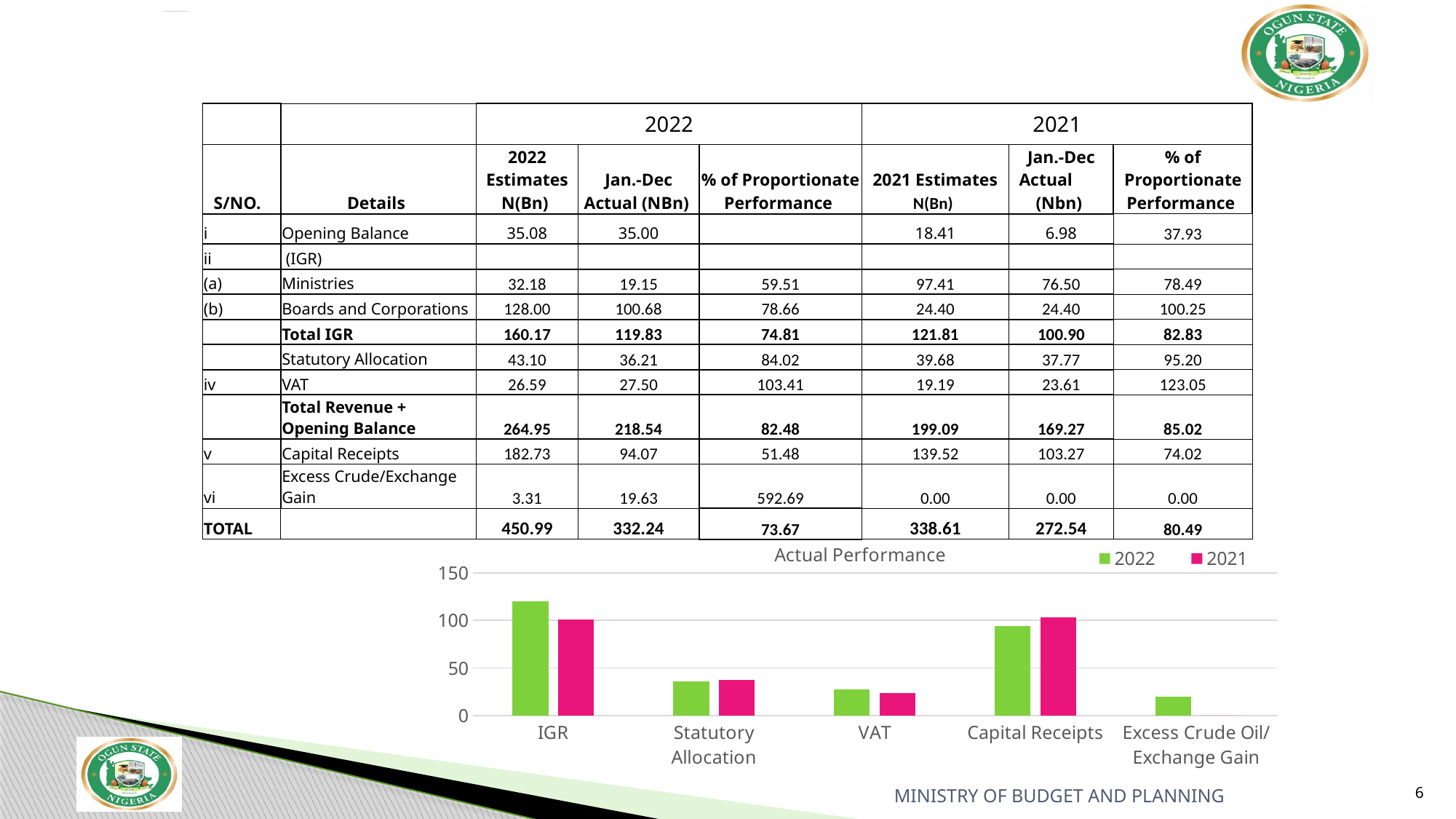
Is the 2022 value for Statutory Allocation greater or less than 50? less How many categories are shown on the x axis of the chart? 5 Which category has the highest 2022 bar in the chart? IGR Is the 2022 value for IGR greater or less than 100? greater Which category has the lowest 2022 bar in the chart? Excess Crude Oil/ Exchange Gain What kind of chart is shown on the slide? bar chart What is the title of the chart? Actual Performance For Capital Receipts, which series has the larger bar, 2022 or 2021? 2021 How many series does the chart legend list? 2 Which category has the lowest 2021 bar in the chart? Excess Crude Oil/ Exchange Gain For IGR, which series has the larger bar, 2022 or 2021? 2022 Which colour represents the 2021 series in the chart? pink